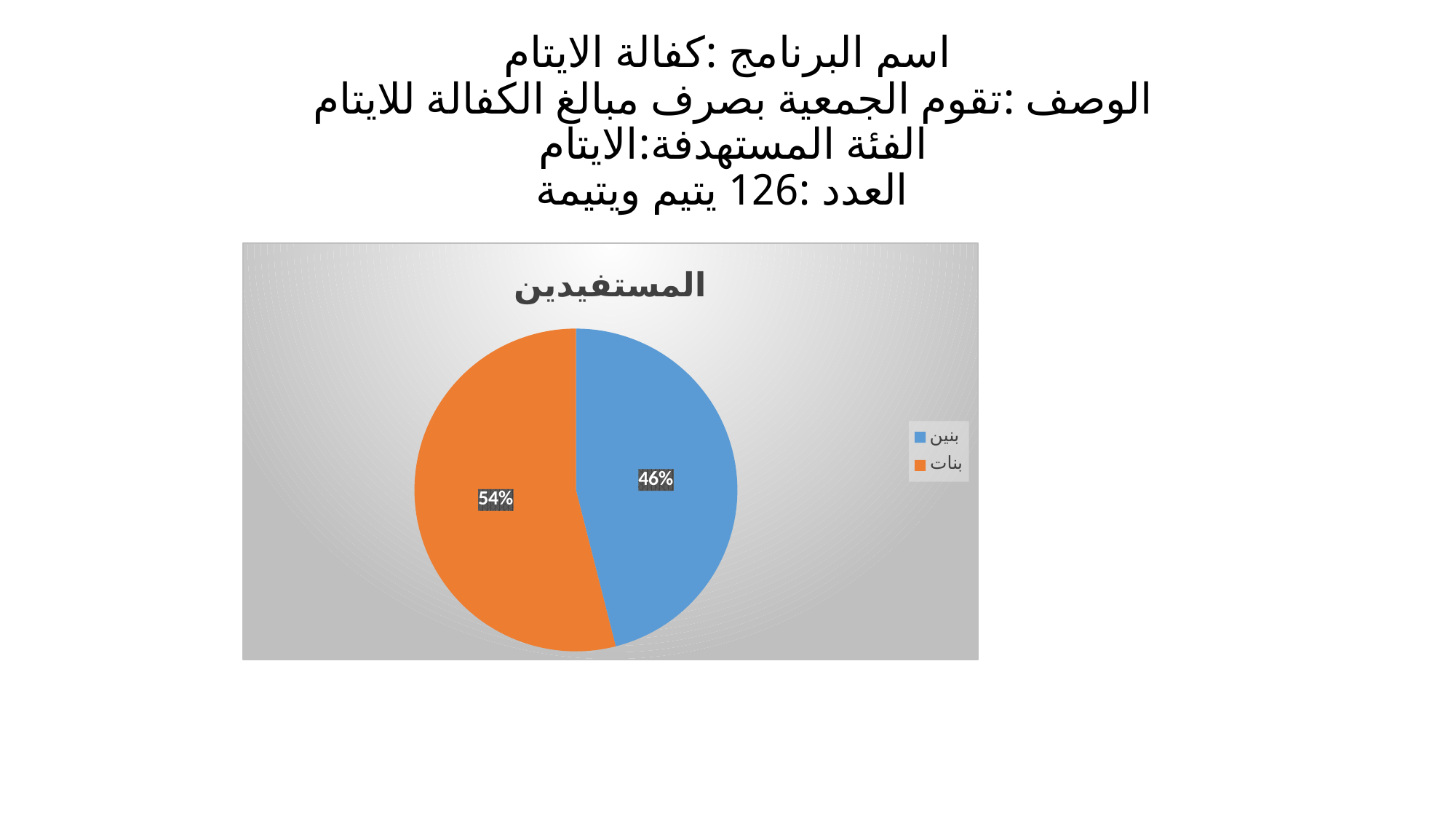
Which category has the smallest share of the pie? بنين How many slices does the pie chart have? 2 What share of the pie does بنات (girls) represent? 54% What is the title of the chart? المستفيدين Which category has the largest share of the pie? بنات How many entries does the legend list? 2 What type of chart is shown on the slide? pie chart What colour is the بنات slice? orange What share of the pie does بنين (boys) represent? 46% What is the difference in percentage points between the بنات and بنين slices? 8% Which slice is larger, بنين or بنات? بنات